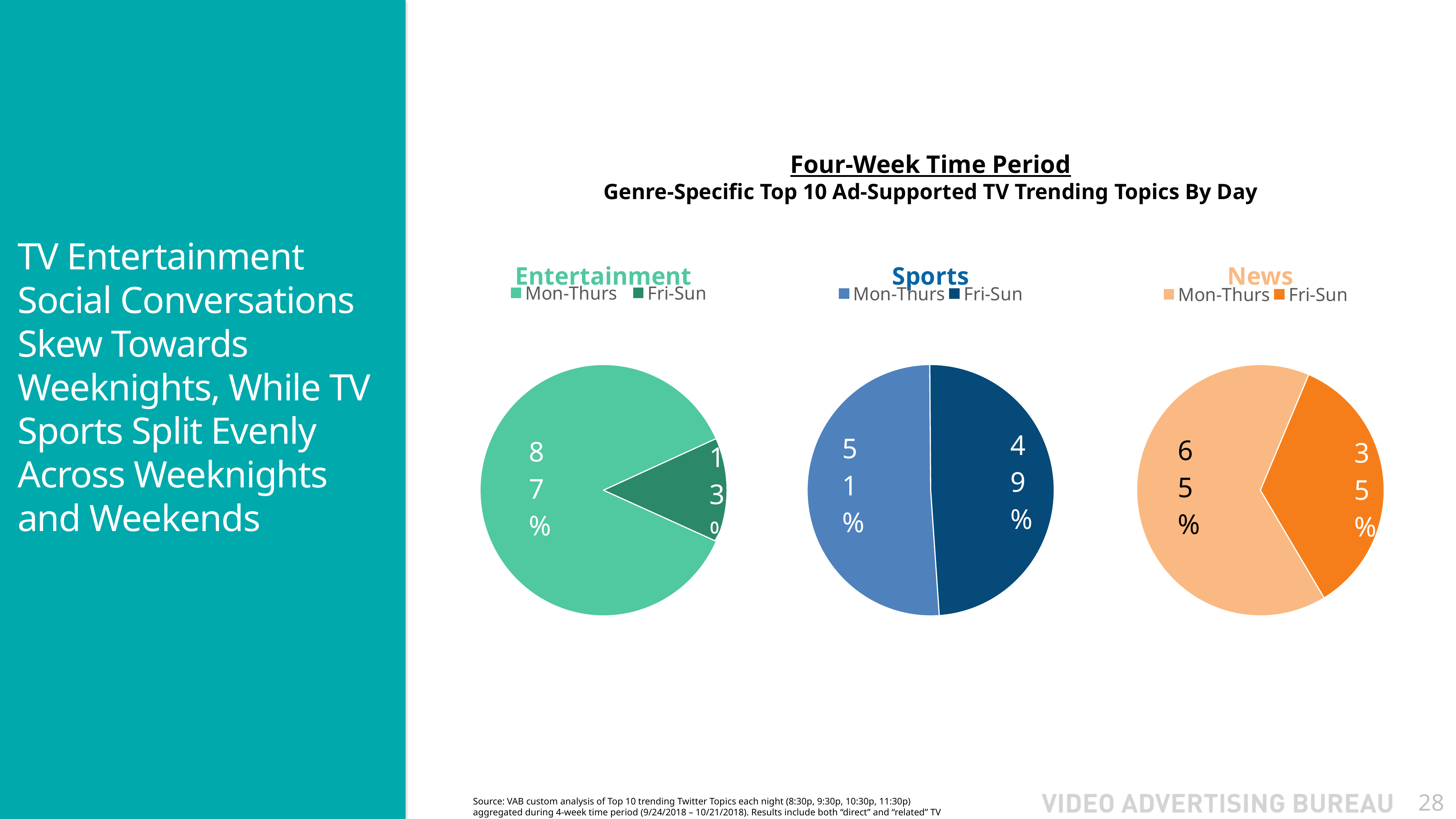
In the Sports pie chart, what is the value for Mon-Thurs? 51% How many series does the legend of the Sports chart list? 2 In the Entertainment pie chart, which slice is the largest? Mon-Thurs In the News pie chart, what is the value for Mon-Thurs? 65% In the Entertainment pie chart, what share of trending topics falls on Mon-Thurs? 87% In the News pie chart, what is the difference between the Mon-Thurs and Fri-Sun shares? 30% What type of chart is used for the Sports genre? Pie chart In the Entertainment pie chart, what is the value for Fri-Sun? 13% In the News pie chart, what is the value for Fri-Sun? 35% In the Entertainment pie chart, what is the difference between the Mon-Thurs and Fri-Sun shares? 74% In the News pie chart, which slice is the smallest? Fri-Sun In the Sports pie chart, what is the value for Fri-Sun? 49%